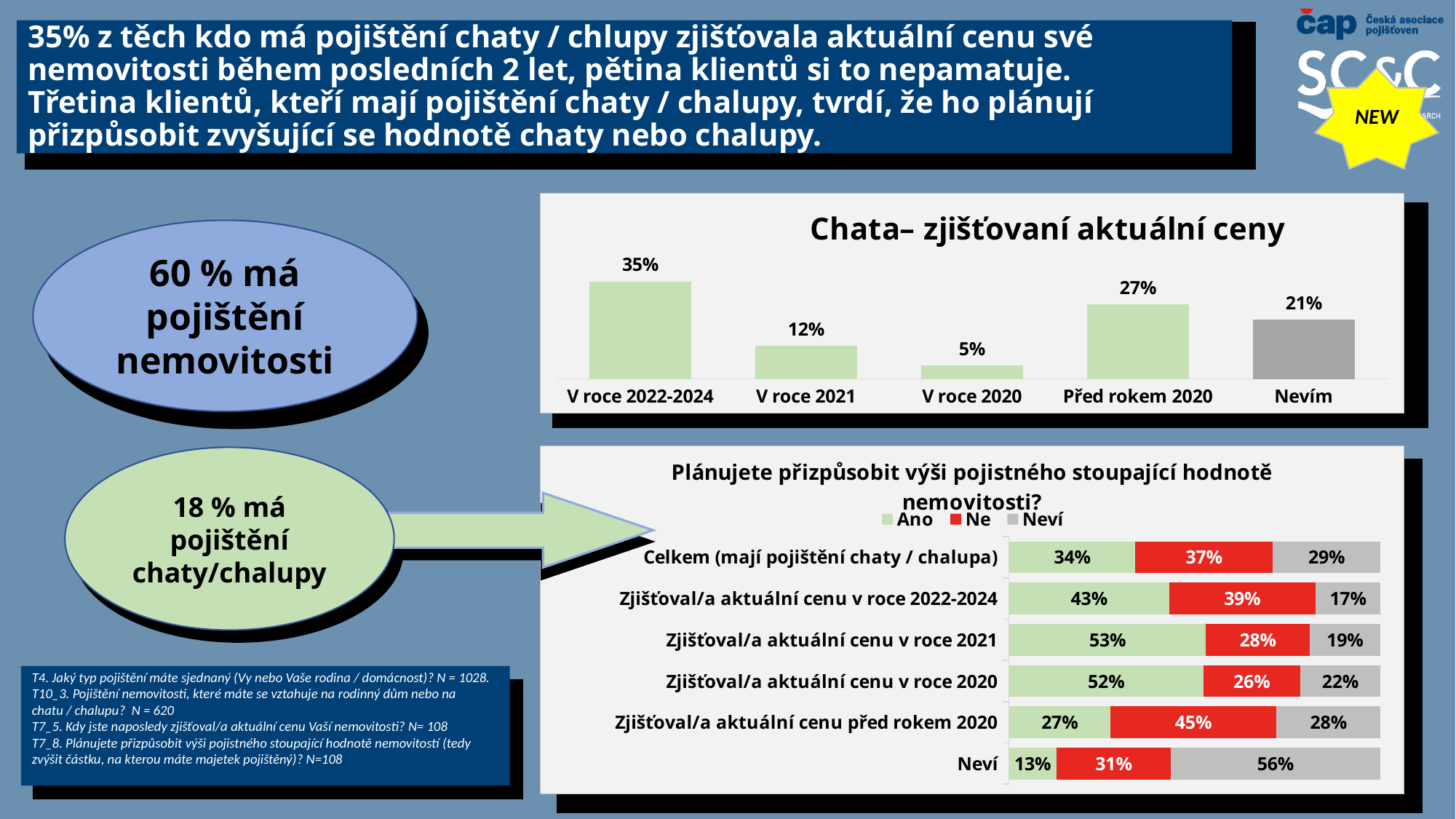
In the chart 'Plánujete přizpůsobit výši pojistného stoupající hodnotě nemovitosti?', is the 'Ano' value for 'Celkem (mají pojištění chaty / chalupa)' larger or smaller than its 'Ne' value? Smaller In the chart 'Chata– zjišťovaní aktuální ceny', which category has the lowest value? V roce 2020 In the chart 'Chata– zjišťovaní aktuální ceny', what is the difference between 'Před rokem 2020' and 'Nevím'? 6% In the chart 'Plánujete přizpůsobit výši pojistného stoupající hodnotě nemovitosti?', which category has the highest 'Neví' value? Neví In the chart 'Plánujete přizpůsobit výši pojistného stoupající hodnotě nemovitosti?', which category has the highest 'Ano' value? Zjišťoval/a aktuální cenu v roce 2021 In the chart 'Chata– zjišťovaní aktuální ceny', how many categories are shown? 5 In the chart 'Plánujete přizpůsobit výši pojistného stoupající hodnotě nemovitosti?', how many series does the legend list? 3 In the chart 'Chata– zjišťovaní aktuální ceny', which category has the highest value? V roce 2022-2024 In the chart 'Plánujete přizpůsobit výši pojistného stoupající hodnotě nemovitosti?', what is the 'Ne' value for 'Zjišťoval/a aktuální cenu před rokem 2020'? 45% In the chart 'Plánujete přizpůsobit výši pojistného stoupající hodnotě nemovitosti?', what is the difference between the 'Ano' values for 'Zjišťoval/a aktuální cenu v roce 2022-2024' and 'Zjišťoval/a aktuální cenu před rokem 2020'? 16% In the chart 'Chata– zjišťovaní aktuální ceny', what is the value for 'V roce 2021'? 12% What type of chart is 'Chata– zjišťovaní aktuální ceny'? Bar chart